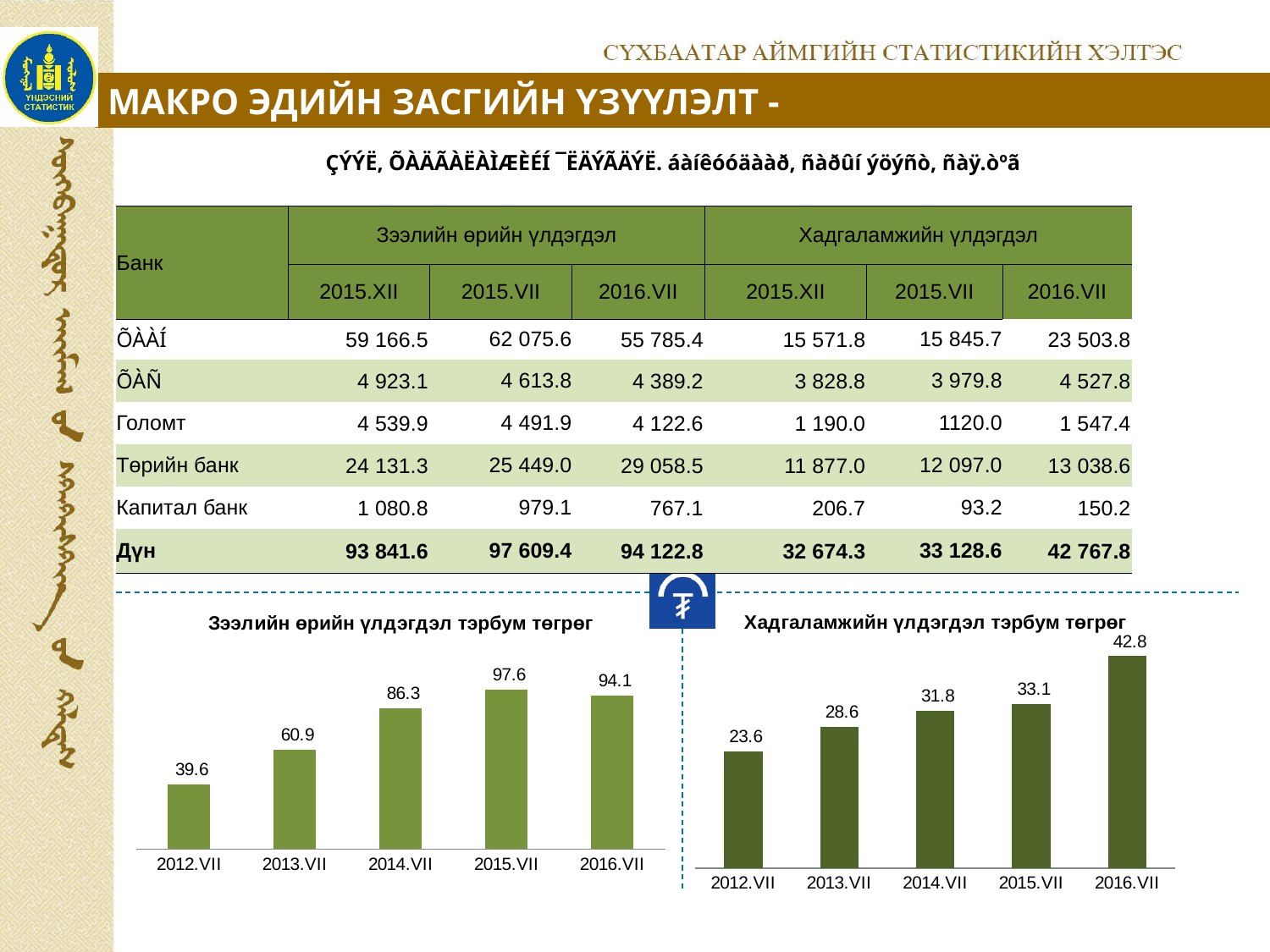
In the chart titled 'Зээлийн өрийн үлдэгдэл тэрбум төгрөг', which is larger: the value for 2013.VII or 2014.VII? 2014.VII In the chart titled 'Зээлийн өрийн үлдэгдэл тэрбум төгрөг', what is the value for 2012.VII? 39.6 How many bars are in the chart titled 'Хадгаламжийн үлдэгдэл тэрбум төгрөг'? 5 In the chart titled 'Хадгаламжийн үлдэгдэл тэрбум төгрөг', which year has the lowest value? 2012.VII In the chart titled 'Хадгаламжийн үлдэгдэл тэрбум төгрөг', do the values rise or fall from 2012.VII to 2016.VII? Rise In the chart titled 'Хадгаламжийн үлдэгдэл тэрбум төгрөг', what is the difference between the values for 2016.VII and 2012.VII? 19.2 In the chart titled 'Хадгаламжийн үлдэгдэл тэрбум төгрөг', what is the value for 2014.VII? 31.8 In the chart titled 'Зээлийн өрийн үлдэгдэл тэрбум төгрөг', what is the value for 2014.VII? 86.3 What kind of chart is the chart titled 'Зээлийн өрийн үлдэгдэл тэрбум төгрөг'? Bar chart In the chart titled 'Зээлийн өрийн үлдэгдэл тэрбум төгрөг', what is the difference between the values for 2015.VII and 2016.VII? 3.5 In the chart titled 'Зээлийн өрийн үлдэгдэл тэрбум төгрөг', which year has the highest value? 2015.VII In the chart titled 'Хадгаламжийн үлдэгдэл тэрбум төгрөг', what is the value for 2016.VII? 42.8